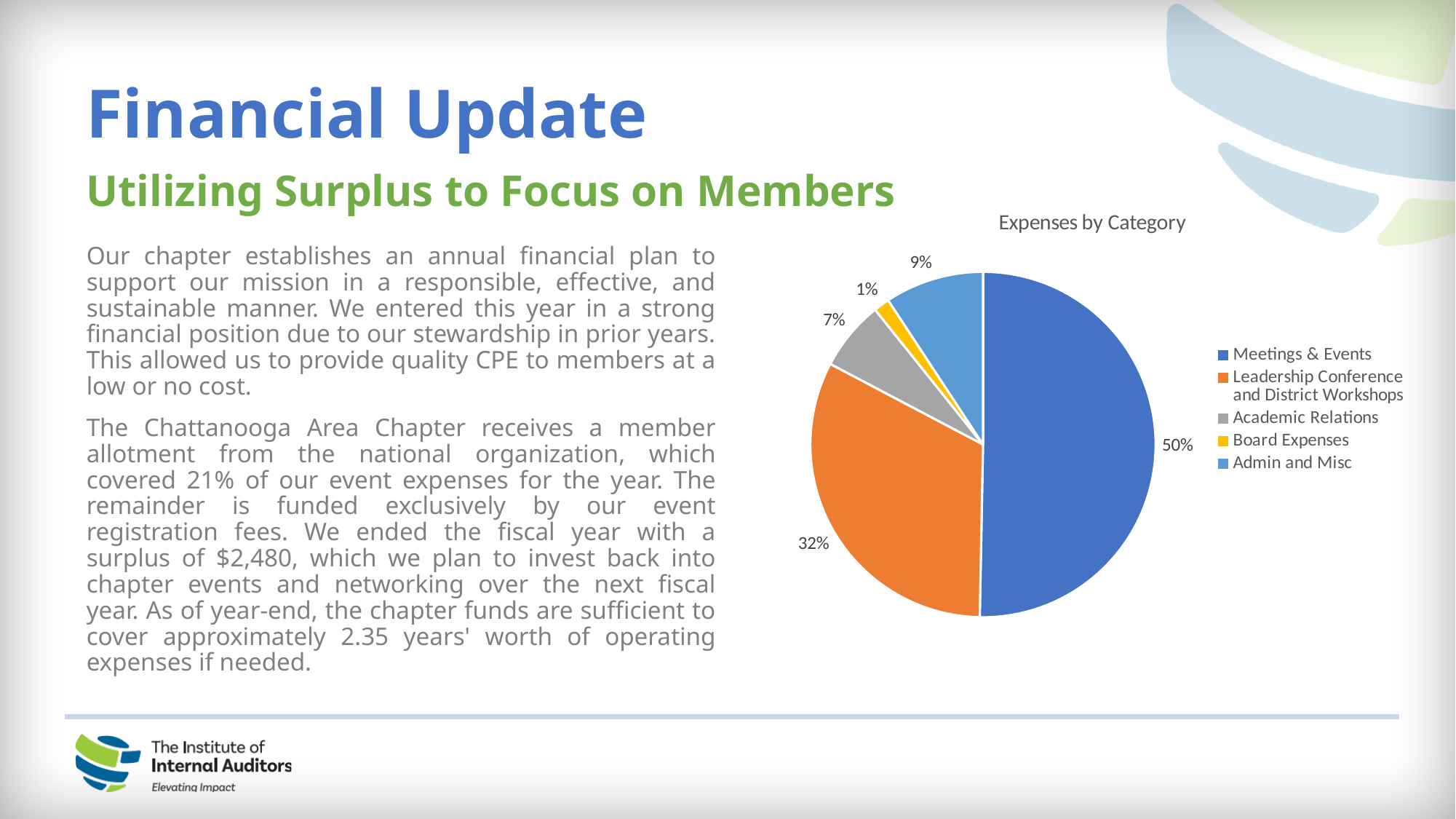
Which is larger, the share for Admin and Misc or the share for Academic Relations? Admin and Misc What share of expenses is Leadership Conference and District Workshops? 32% What type of chart is shown on the slide? pie chart What share of expenses is Admin and Misc? 9% What share of expenses is Board Expenses? 1% Which category has the largest share of expenses? Meetings & Events What is the title of the chart? Expenses by Category Which category has the smallest share of expenses? Board Expenses How many categories does the pie chart show? 5 What is the difference in percentage points between Meetings & Events and Leadership Conference and District Workshops? 18